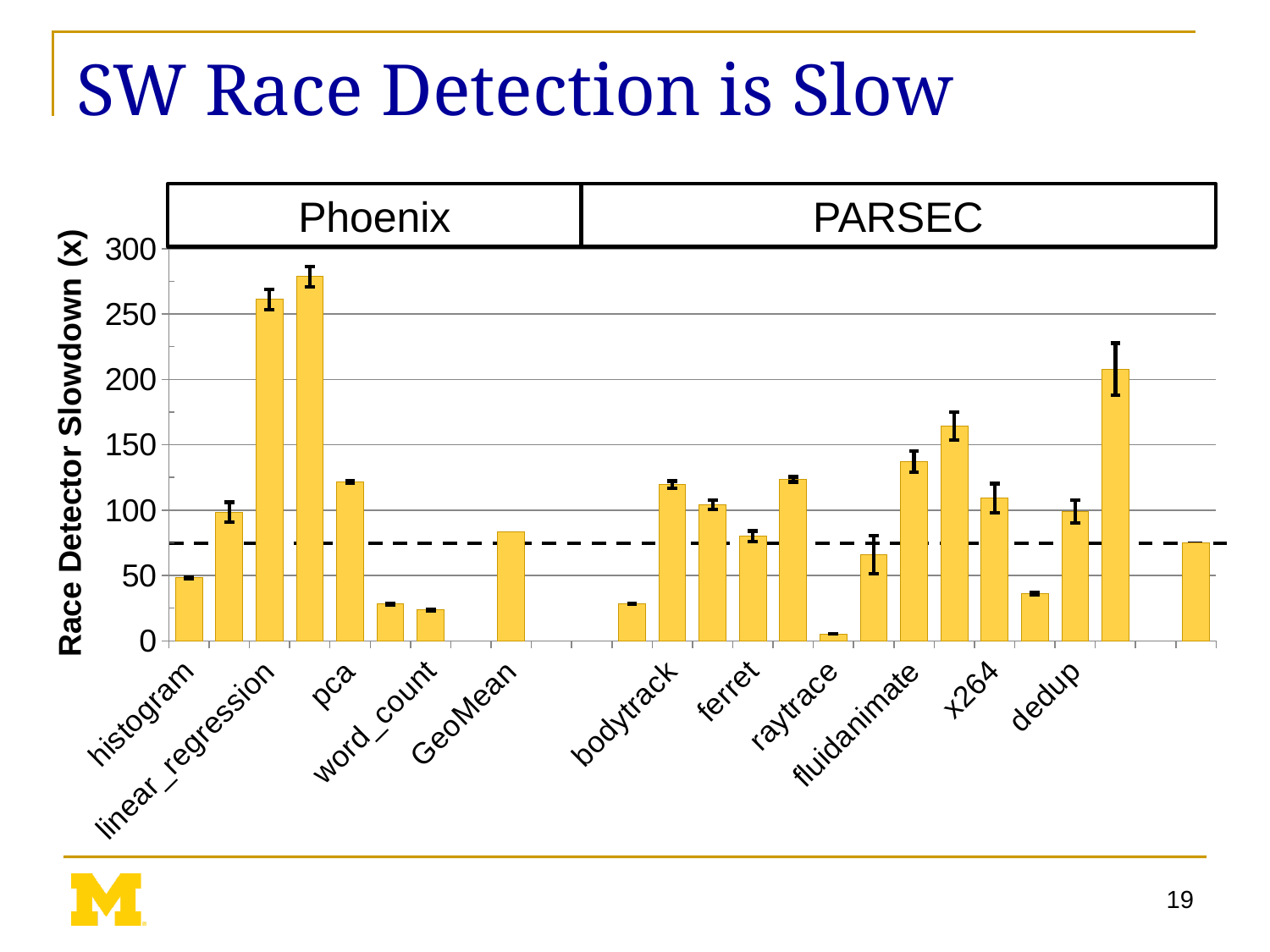
Which has the larger value, linear_regression or pca? linear_regression Is the value for linear_regression greater or less than 250? greater Is the value for raytrace greater or less than 50? less Is the value for word_count greater or less than 50? less What kind of chart is shown on the slide? bar chart What are the two benchmark suite groups labelled above the chart? Phoenix and PARSEC Which has the smaller value, raytrace or histogram? raytrace What is the label of the y axis? Race Detector Slowdown (x)